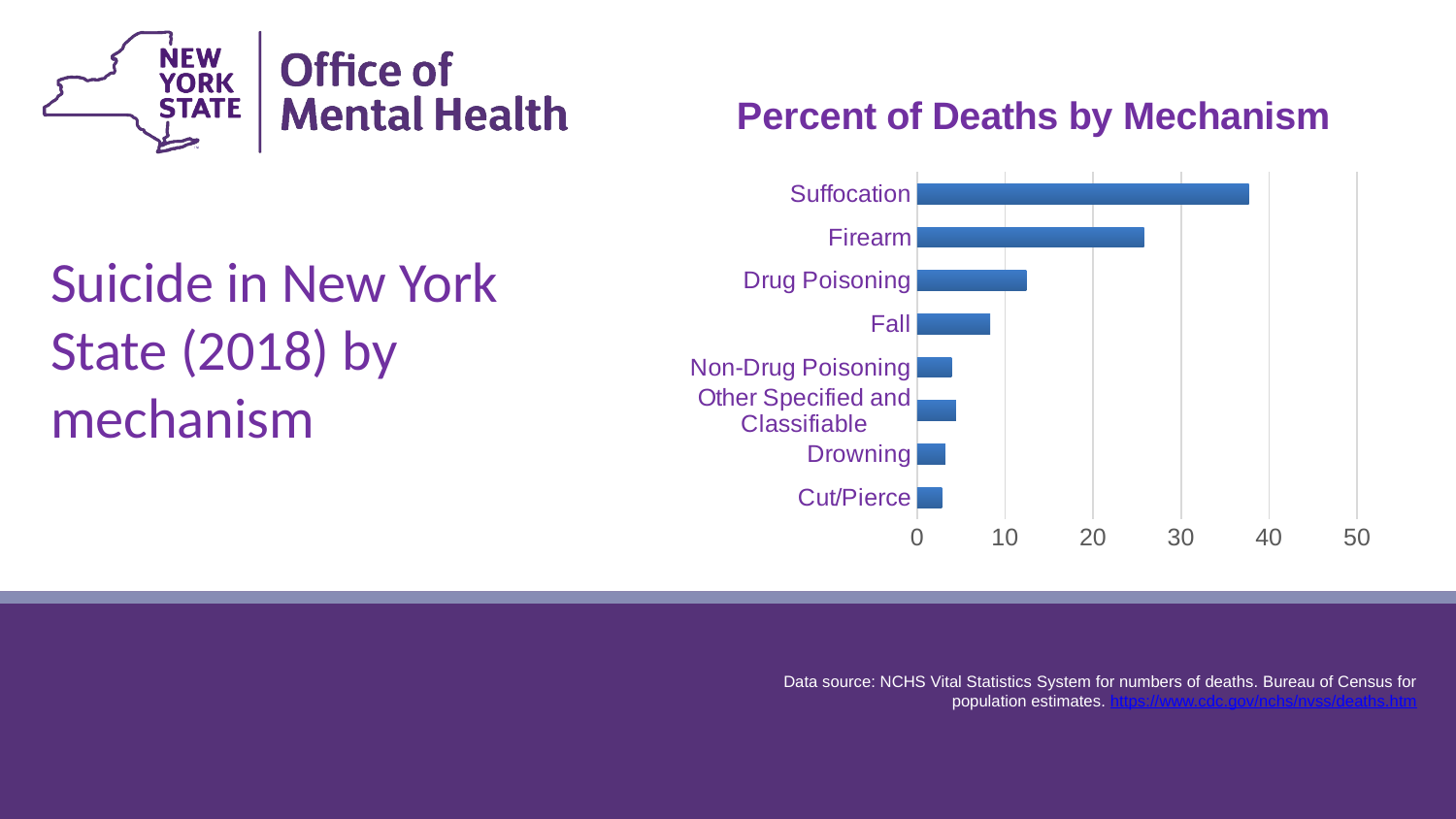
Is the value for Firearm greater or less than 20? greater Is the value for Drug Poisoning greater or less than 20? less What is the title of the chart? Percent of Deaths by Mechanism What is the highest value shown on the horizontal axis of the chart? 50 Which is larger, the value for Firearm or the value for Drug Poisoning? Firearm Is the value for Fall greater or less than 10? less Which mechanism has the highest percent of deaths? Suffocation Which is larger, the value for Fall or the value for Non-Drug Poisoning? Fall How many mechanism categories are plotted in the chart? 8 What kind of chart is shown on the slide? bar chart